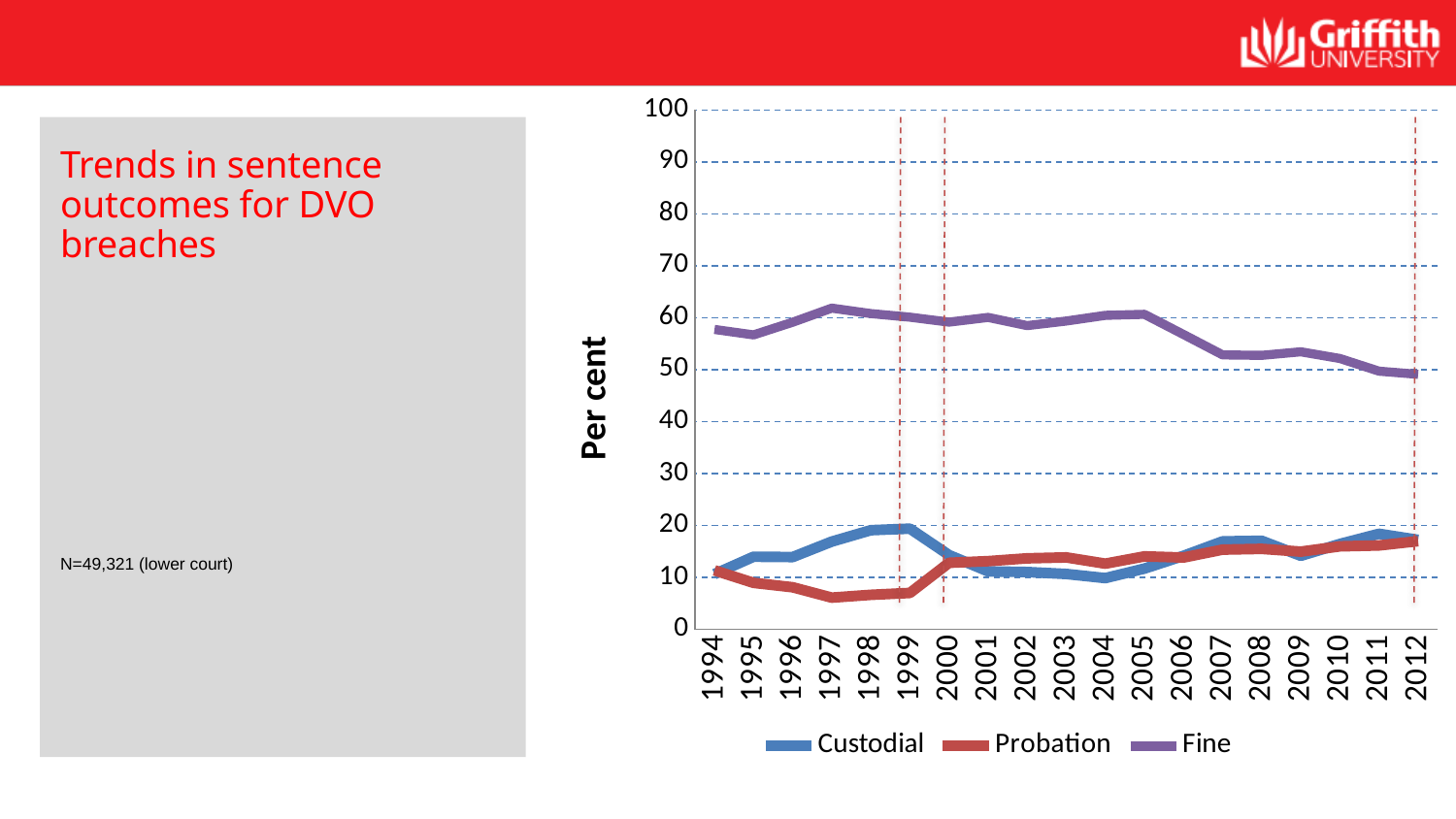
Is the value for Fine in 1997 greater or less than 60? greater Is the value for Custodial in 1999 greater or less than 10? greater Does the Fine series rise or fall overall from 1994 to 2012? fall In 1998, which is larger: Custodial or Probation? Custodial What is the label on the vertical axis? Per cent How many series does the legend list? 3 How many years are shown along the x axis? 19 What kind of chart is shown on the slide? line chart Which series has the highest values across all years? Fine Is the value for Probation in 1997 greater or less than 10? less Which series are listed in the legend? Custodial, Probation, Fine